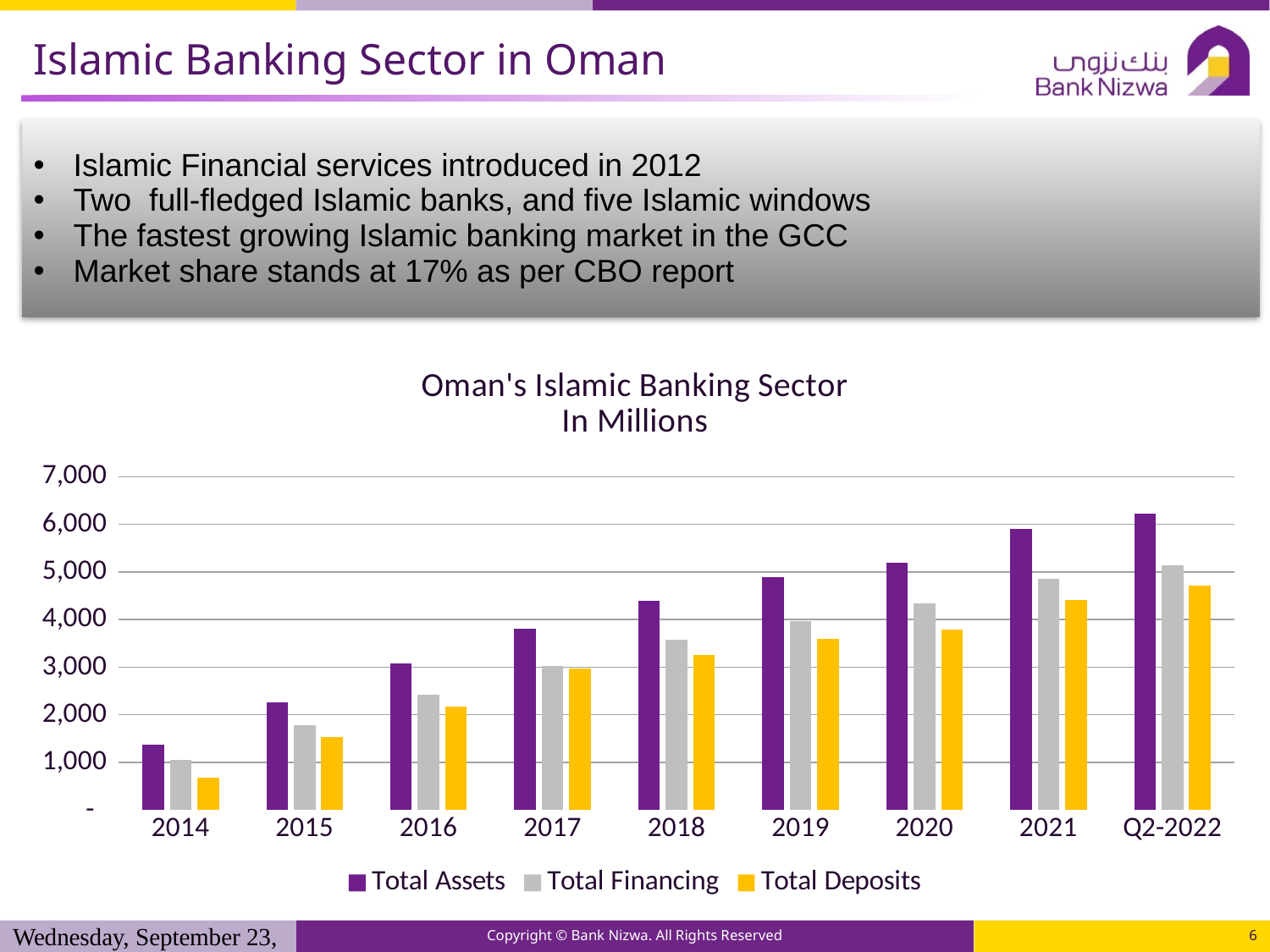
In which period is Total Assets highest? Q2-2022 How many series does the legend list? 3 Is the value for Total Deposits in Q2-2022 greater or less than 5,000? less Is the value for Total Deposits in 2014 greater or less than 1,000? less Is the value for Total Assets in 2021 greater or less than 5,000? greater Which is larger: Total Assets in 2018 or Total Financing in 2021? Total Financing in 2021 Do the Total Assets values rise or fall from 2014 to Q2-2022? rise How many periods are shown along the x axis? 9 Which series is shown in yellow? Total Deposits What kind of chart is shown on the slide? bar chart In which period is Total Deposits lowest? 2014